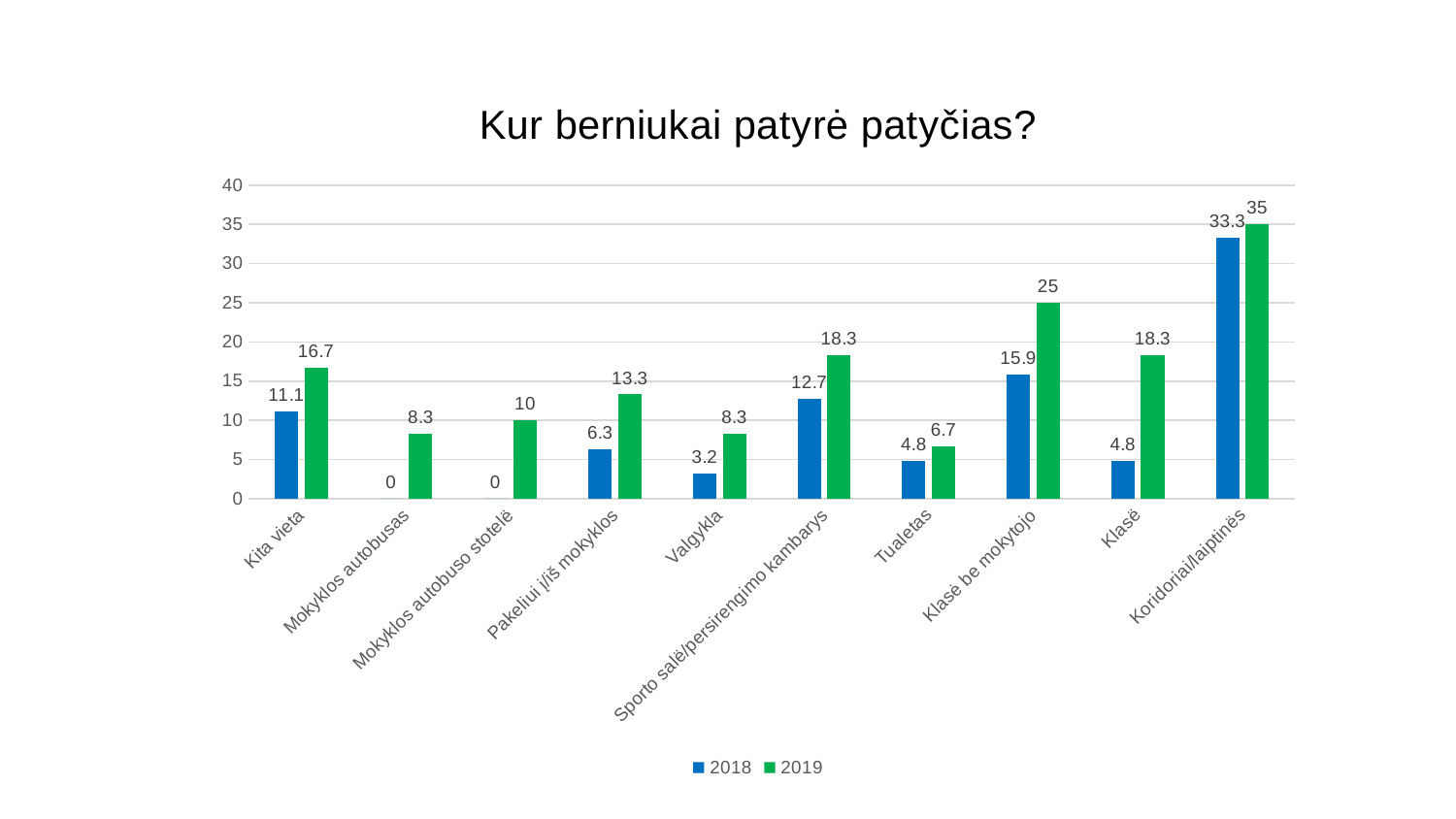
Is the 2018 value for Koridoriai/laiptinės greater or less than 30? greater How many series does the legend list? 2 Which category has the highest 2019 value? Koridoriai/laiptinės Which is larger for Valgykla: the 2018 value or the 2019 value? 2019 How many categories are shown on the x axis? 10 What is the 2019 value for Klasė be mokytojo? 25 What is the difference between the 2019 and 2018 values for Klasė? 13.5 Which category has the lowest 2019 value? Tualetas What is the title of the chart? Kur berniukai patyrė patyčias? What is the 2018 value for Sporto salė/persirengimo kambarys? 12.7 What is the 2018 value for Mokyklos autobusas? 0 What kind of chart is shown on the slide? bar chart